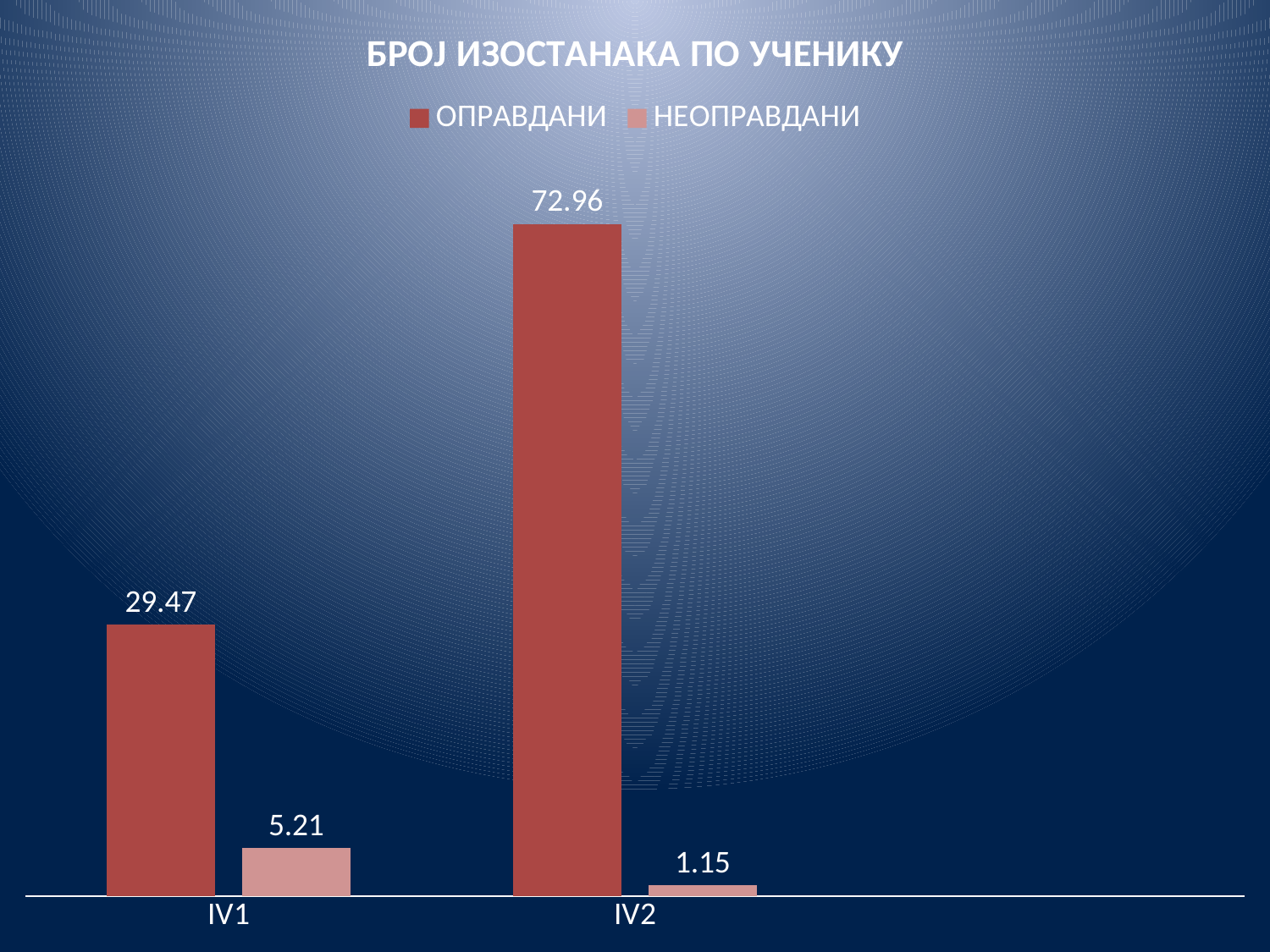
How many categories are shown on the x axis? 2 What is the difference between the ОПРАВДАНИ values for IV2 and IV1? 43.49 What is the value of ОПРАВДАНИ for IV2? 72.96 How many series does the legend list? 2 What is the value of НЕОПРАВДАНИ for IV1? 5.21 Which is larger: НЕОПРАВДАНИ for IV1 or НЕОПРАВДАНИ for IV2? IV1 What is the value of НЕОПРАВДАНИ for IV2? 1.15 What is the value of ОПРАВДАНИ for IV1? 29.47 What is the title of the chart? БРОЈ ИЗОСТАНАКА ПО УЧЕНИКУ Which category has the highest ОПРАВДАНИ value? IV2 What kind of chart is shown on the slide? Bar chart Which category has the lowest НЕОПРАВДАНИ value? IV2